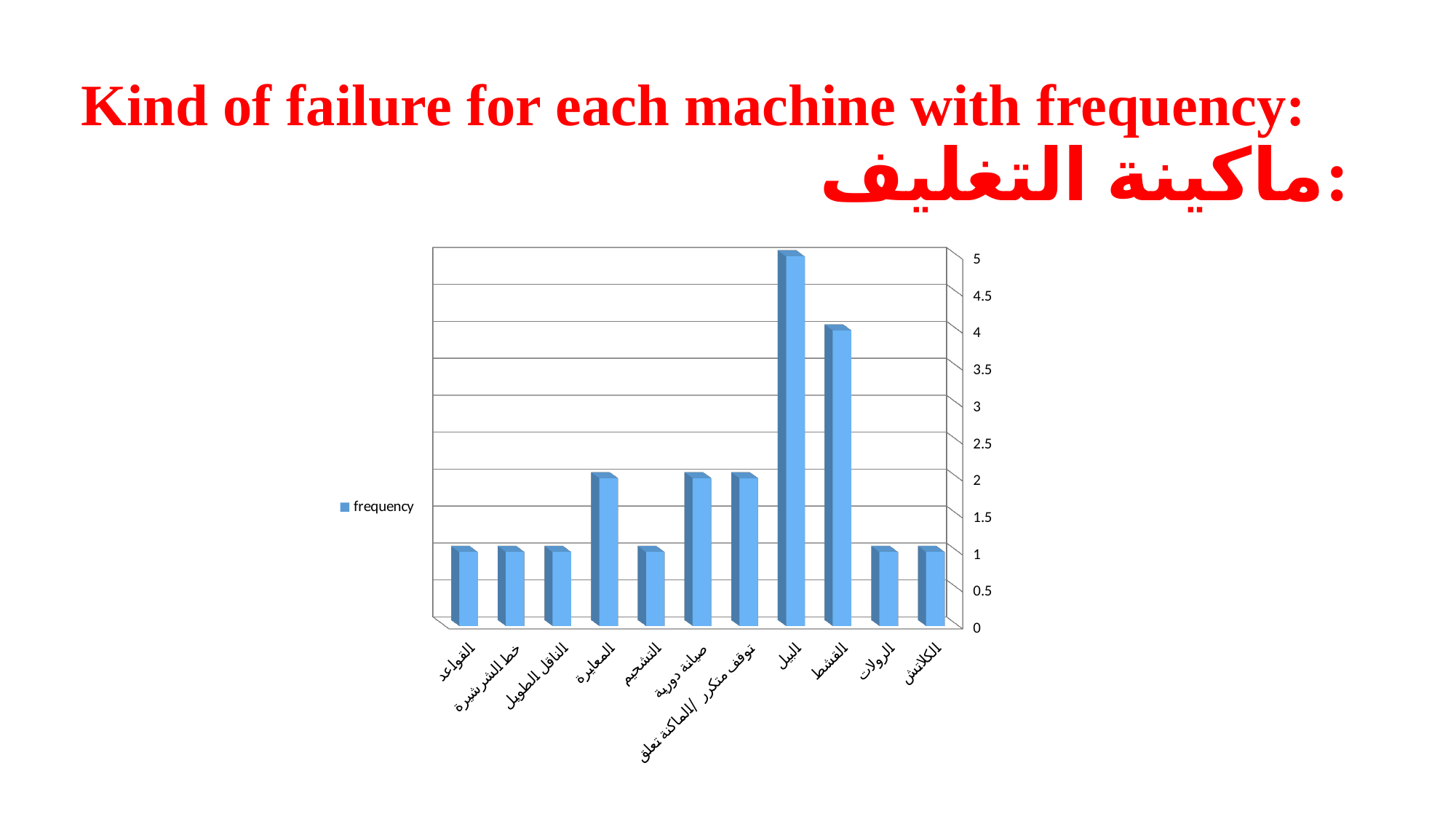
What is the frequency for المعايرة? 2 How many categories are shown on the x axis of the chart? 11 What is the name of the series shown in the legend? frequency What is the frequency for القواعد? 1 How many series does the legend list? 1 Which category has the highest frequency? البيل Which is larger, the frequency for صيانة دورية or the frequency for الرولات? صيانة دورية What type of chart is shown on the slide? bar chart